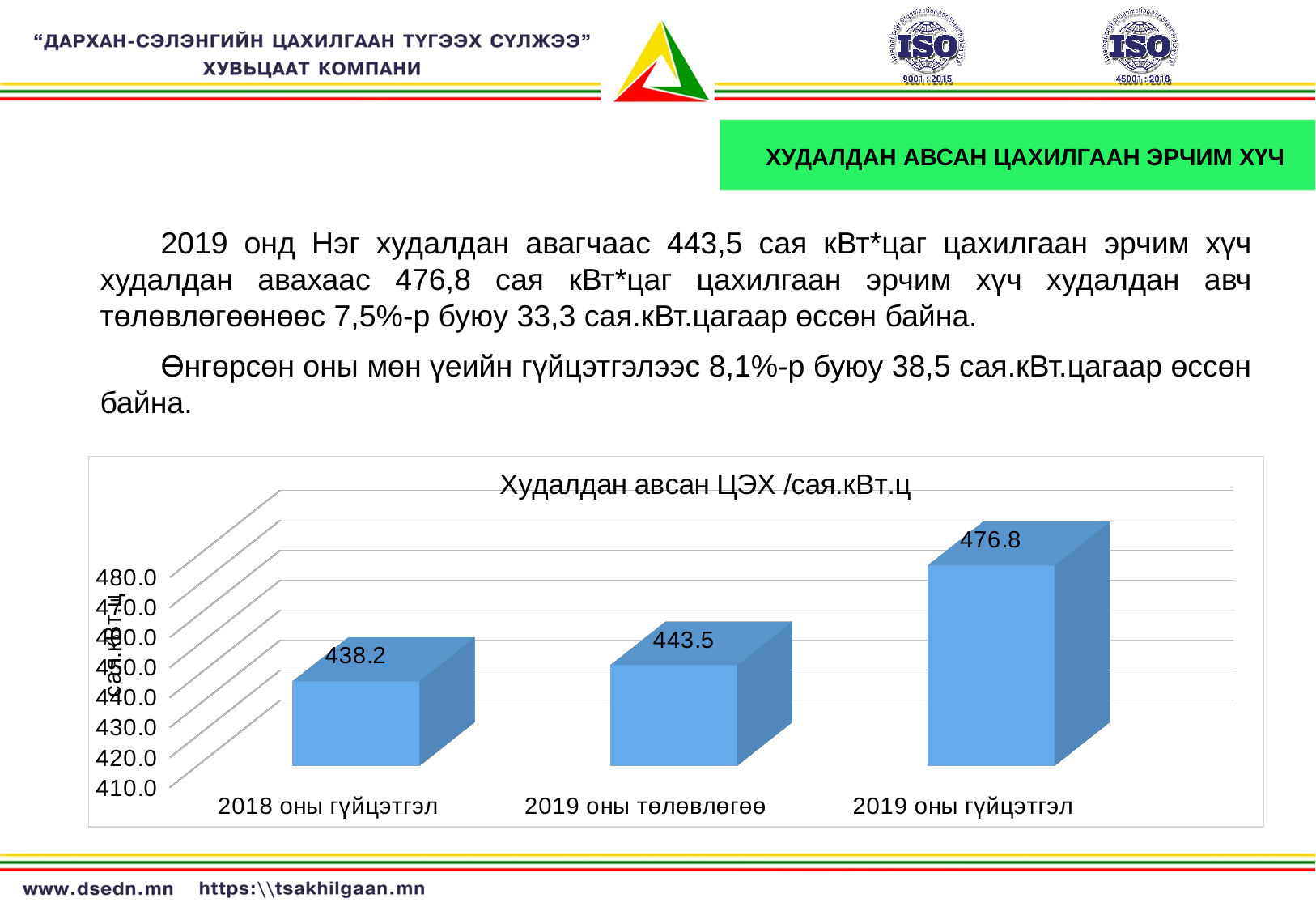
What is the difference between the values for 2019 оны гүйцэтгэл and 2019 оны төлөвлөгөө? 33.3 What is the value for 2018 оны гүйцэтгэл in the chart? 438.2 What kind of chart is shown on the slide? bar chart What is the value for 2019 оны гүйцэтгэл in the chart? 476.8 Which is larger, the value for 2019 оны төлөвлөгөө or the value for 2018 оны гүйцэтгэл? 2019 оны төлөвлөгөө What is the value for 2019 оны төлөвлөгөө in the chart? 443.5 Is the value for 2019 оны гүйцэтгэл greater or less than 470.0? greater Which category has the lowest value in the chart? 2018 оны гүйцэтгэл Which category has the highest value in the chart? 2019 оны гүйцэтгэл What is the difference between the values for 2019 оны гүйцэтгэл and 2018 оны гүйцэтгэл? 38.6 What is the title of the chart? Худалдан авсан ЦЭХ /сая.кВт.ц How many categories are shown in the chart? 3